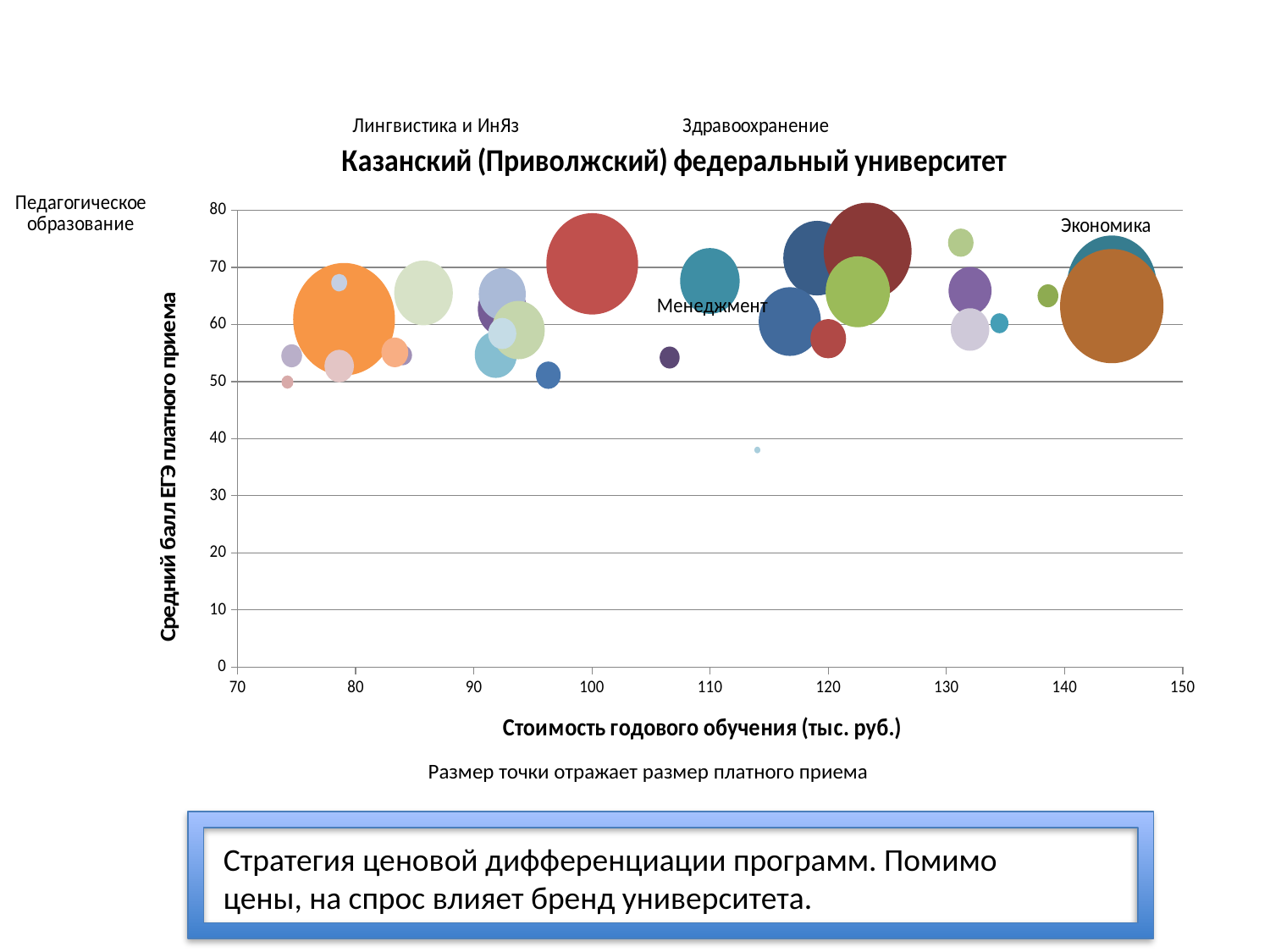
What is the title of the chart? Казанский (Приволжский) федеральный университет Is the x-axis value (cost of annual tuition) for Менеджмент greater or less than 100? greater What is the title of the x axis of the chart? Стоимость годового обучения (тыс. руб.) What kind of chart is shown on the slide? bubble chart Is the y-axis value (average ЕГЭ score) for Менеджмент greater or less than 50? greater Is the x-axis value (cost of annual tuition) for Экономика greater or less than 140? greater